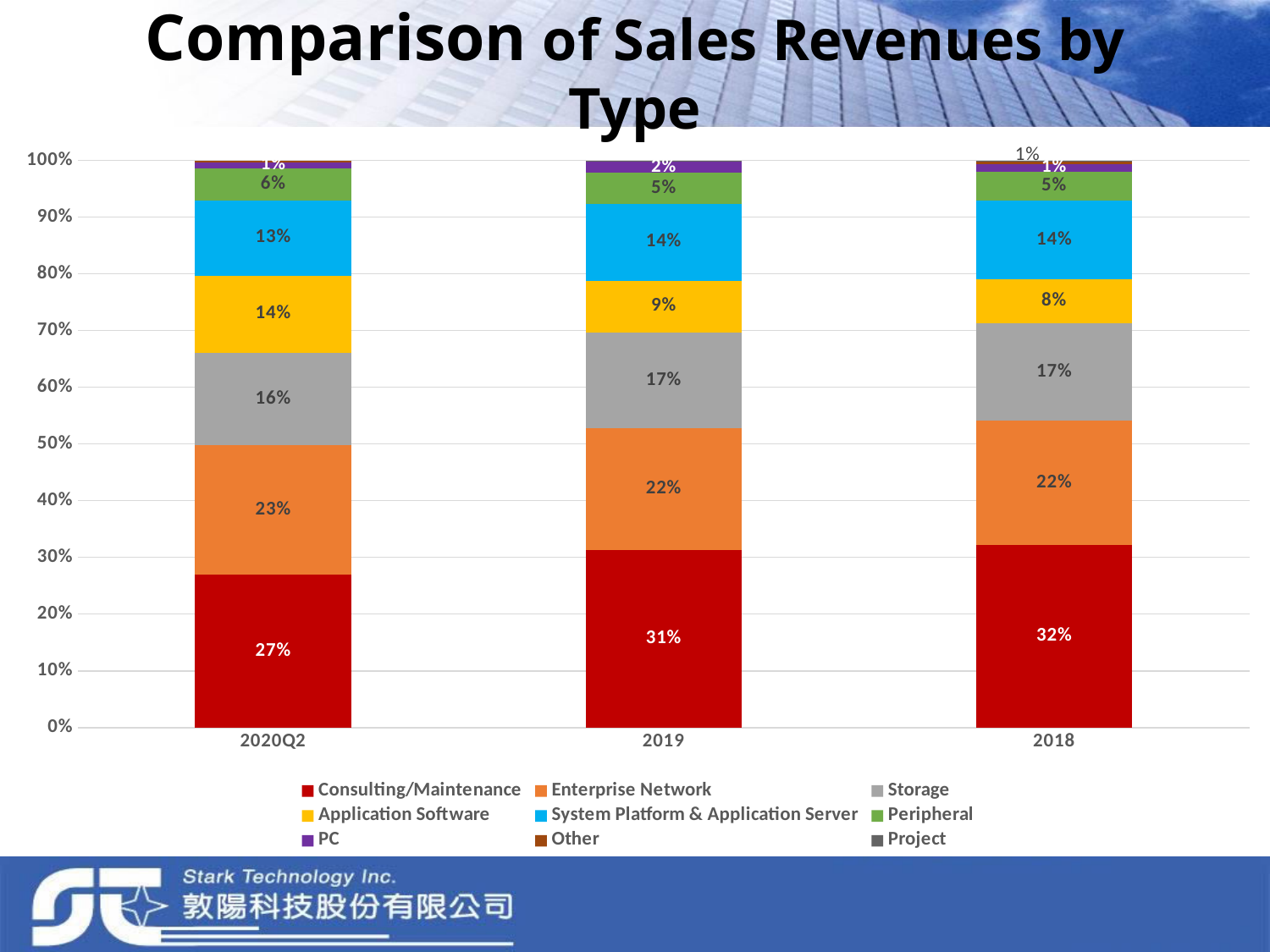
What is the Storage share for 2018? 17% What kind of chart is shown on the slide? Stacked bar chart Which is larger in 2019: the Storage share or the System Platform & Application Server share? Storage What is the difference between the Consulting/Maintenance share in 2018 and in 2020Q2? 5% How many periods are shown on the x axis? 3 What is the Enterprise Network share for 2020Q2? 23% In which period is the Consulting/Maintenance share highest? 2018 How many series does the legend list? 9 What is the Consulting/Maintenance share for 2020Q2? 27% What is the title of the chart? Comparison of Sales Revenues by Type In which period is the Application Software share lowest? 2018 What is the Application Software share for 2019? 9%